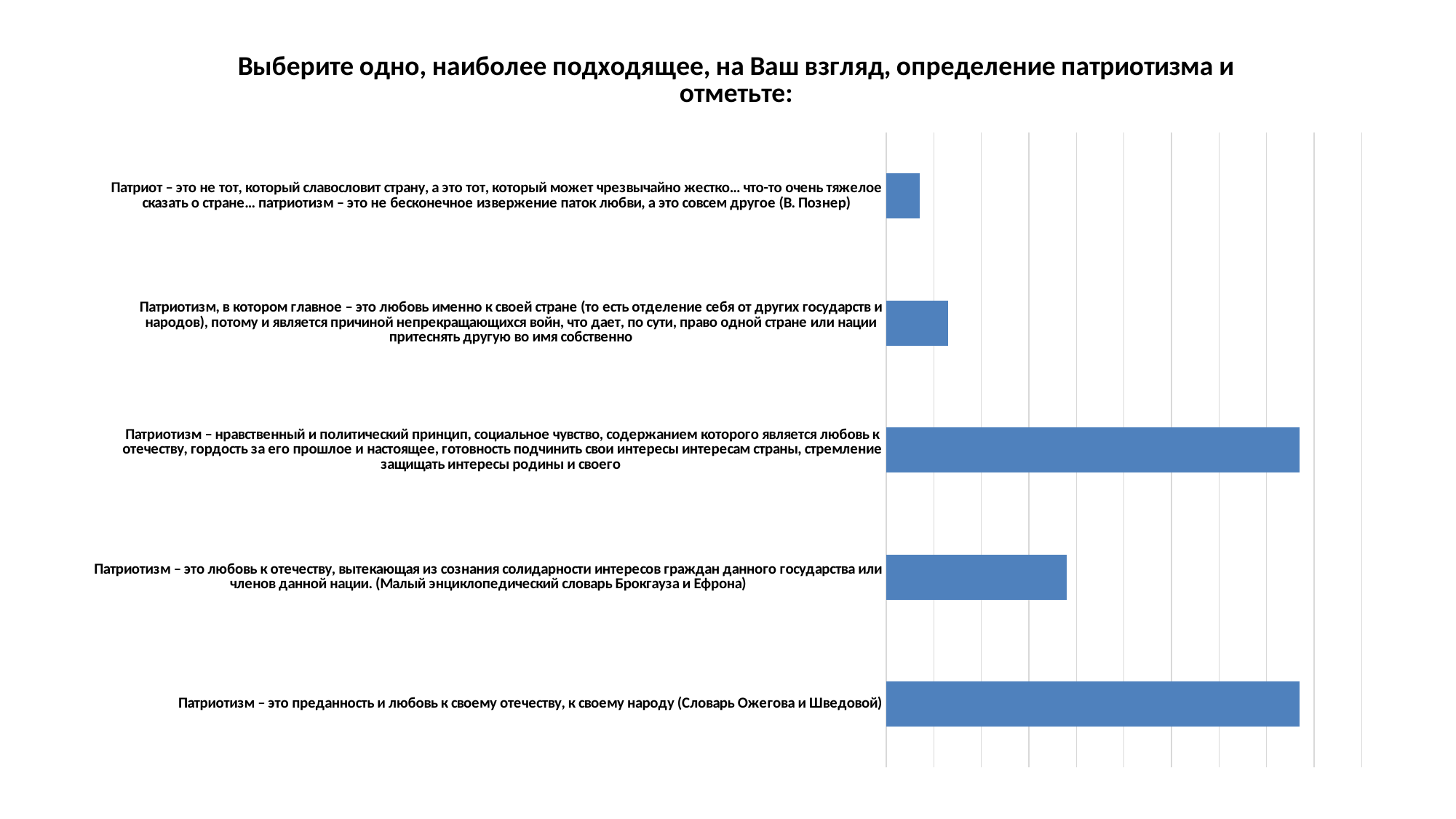
Which is larger: the value for 'Патриотизм, в котором главное – это любовь именно к своей стране...' or the value for the definition by В. Познер? Патриотизм, в котором главное – это любовь именно к своей стране... How many categories (definitions of patriotism) are plotted in the chart? 5 What kind of chart is shown on the slide? bar chart Which is larger: the value for the definition from the Малый энциклопедический словарь Брокгауза и Ефрона or the value for the definition by В. Познер? Малый энциклопедический словарь Брокгауза и Ефрона Which is larger: the value for the definition from the Словарь Ожегова и Шведовой or the value for the definition from the Малый энциклопедический словарь Брокгауза и Ефрона? Словарь Ожегова и Шведовой What colour are the bars in the chart? blue Which definition has the lowest value in the chart? Патриот – это не тот, который славословит страну... (В. Познер) What is the title of the chart? Выберите одно, наиболее подходящее, на Ваш взгляд, определение патриотизма и отметьте: